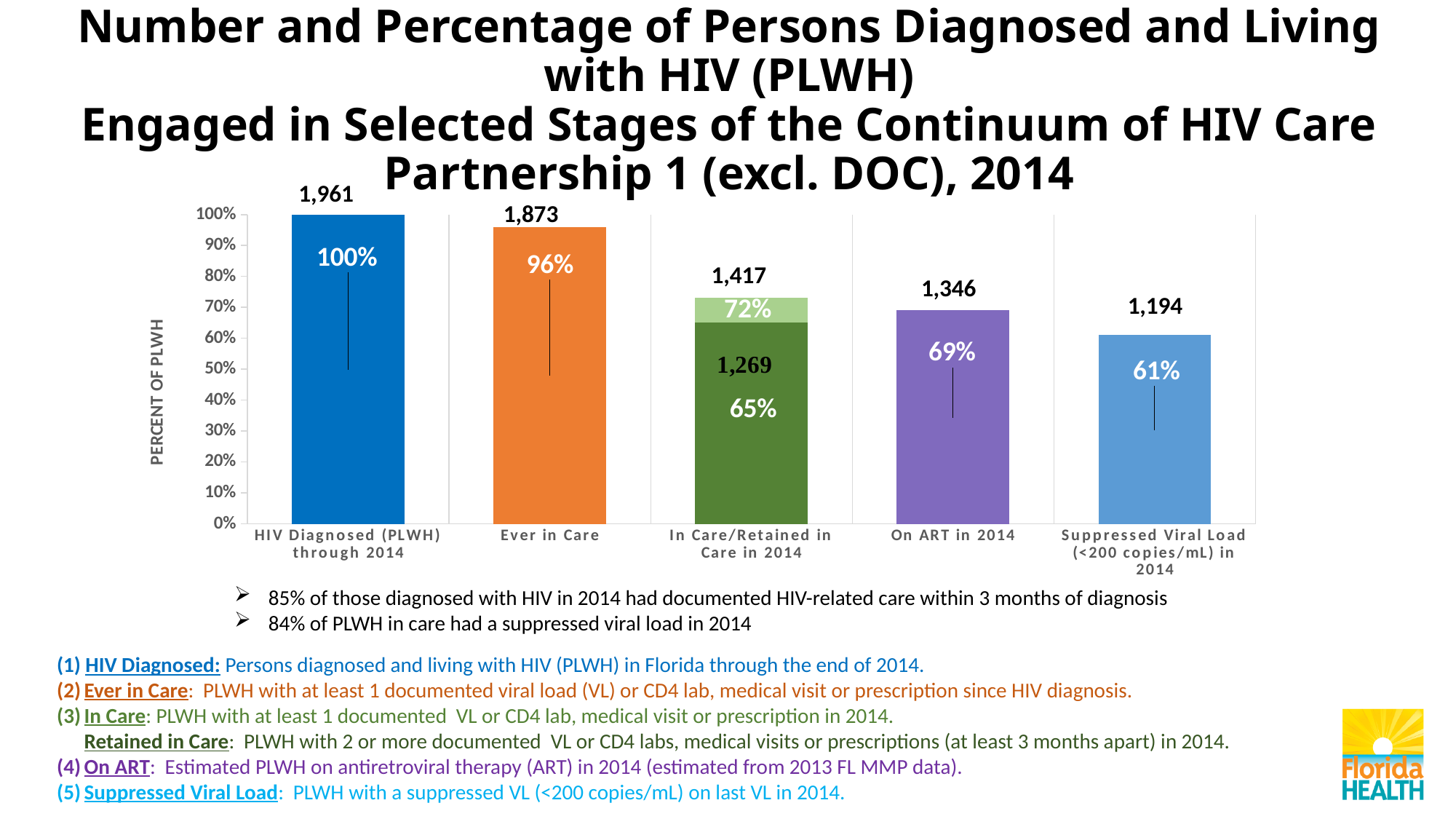
Which is larger: the number of persons 'On ART in 2014' or the number 'Retained in Care' (1,269) in 2014? On ART in 2014 Which category has the highest number of persons? HIV Diagnosed (PLWH) through 2014 What is the difference in the number of persons between 'HIV Diagnosed (PLWH) through 2014' and 'Ever in Care'? 88 How many categories are shown along the x axis of the chart? 5 What percentage is shown for the darker green 'Retained in Care' portion of the 'In Care/Retained in Care in 2014' bar? 65% What is the label on the vertical axis of the chart? PERCENT OF PLWH What kind of chart is shown on the slide? Bar chart What percentage of PLWH is shown for 'On ART in 2014'? 69% What is the number of persons shown for 'Ever in Care'? 1,873 Do the percentages fall or rise moving from left to right across the categories? Fall Which category has the lowest percentage of PLWH? Suppressed Viral Load (<200 copies/mL) in 2014 What is the number of persons shown for 'Suppressed Viral Load (<200 copies/mL) in 2014'? 1,194